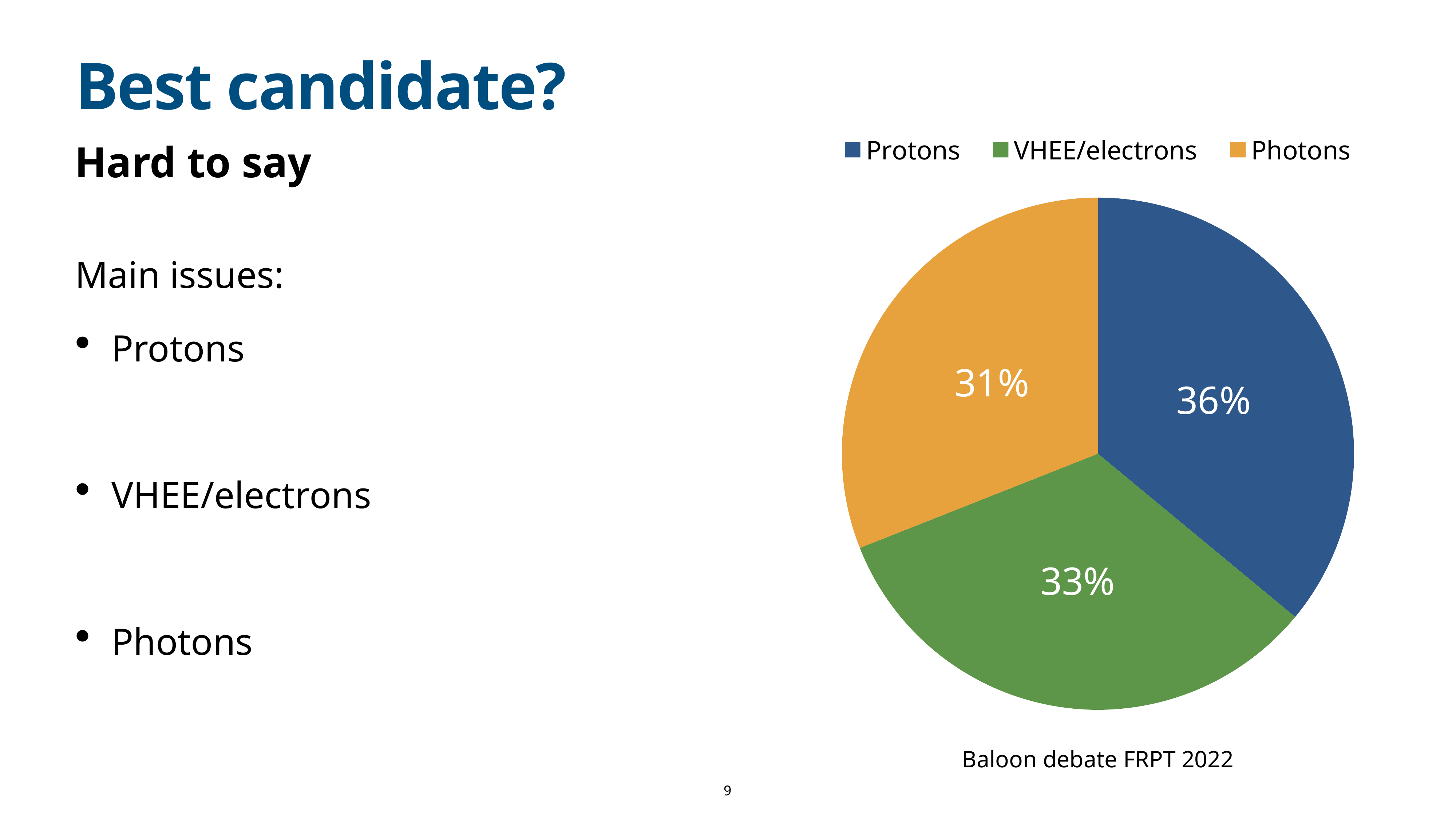
What colour is the Photons slice? Orange How many entries does the legend list? 3 What percentage of the pie is Photons? 31% What kind of chart is shown on the slide? Pie chart Which category has the largest share of the pie? Protons What percentage of the pie is VHEE/electrons? 33% What is the difference in percentage points between Protons and Photons? 5 Which has a larger share, VHEE/electrons or Photons? VHEE/electrons What percentage of the pie is Protons? 36% How many slices does the pie chart have? 3 What is the difference in percentage points between Protons and VHEE/electrons? 3 Which category has the smallest share of the pie? Photons